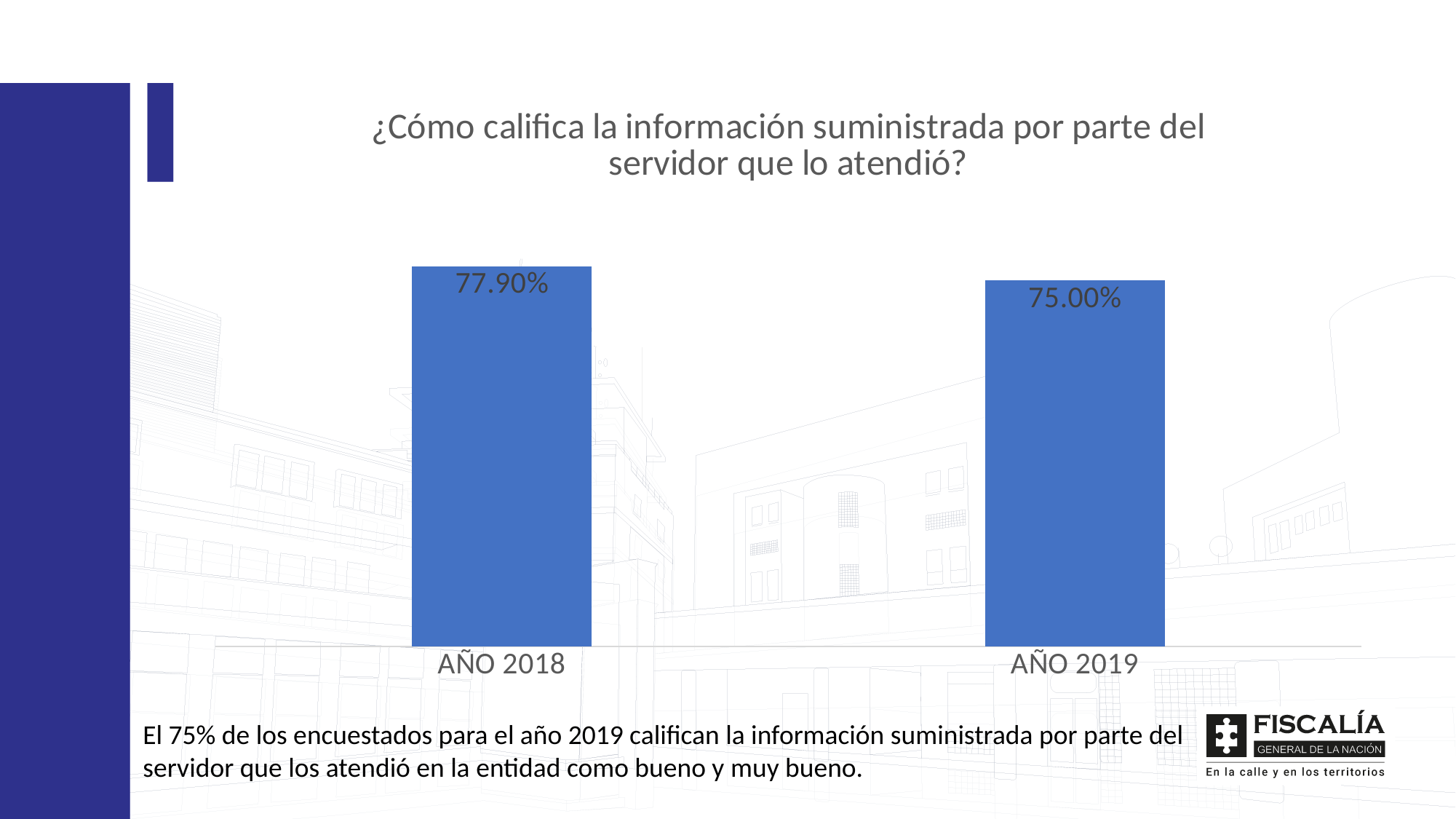
How many categories are shown in the chart? 2 What is the value for AÑO 2019? 75.00% Which year has the lowest value? AÑO 2019 What colour are the bars in the chart? Blue Which is larger, the value for AÑO 2018 or AÑO 2019? AÑO 2018 What is the value for AÑO 2018? 77.90% What kind of chart is shown on the slide? Bar chart What is the title of the chart? ¿Cómo califica la información suministrada por parte del servidor que lo atendió? What is the difference between the values for AÑO 2018 and AÑO 2019? 2.90% Do the values rise or fall from AÑO 2018 to AÑO 2019? Fall Which year has the highest value? AÑO 2018